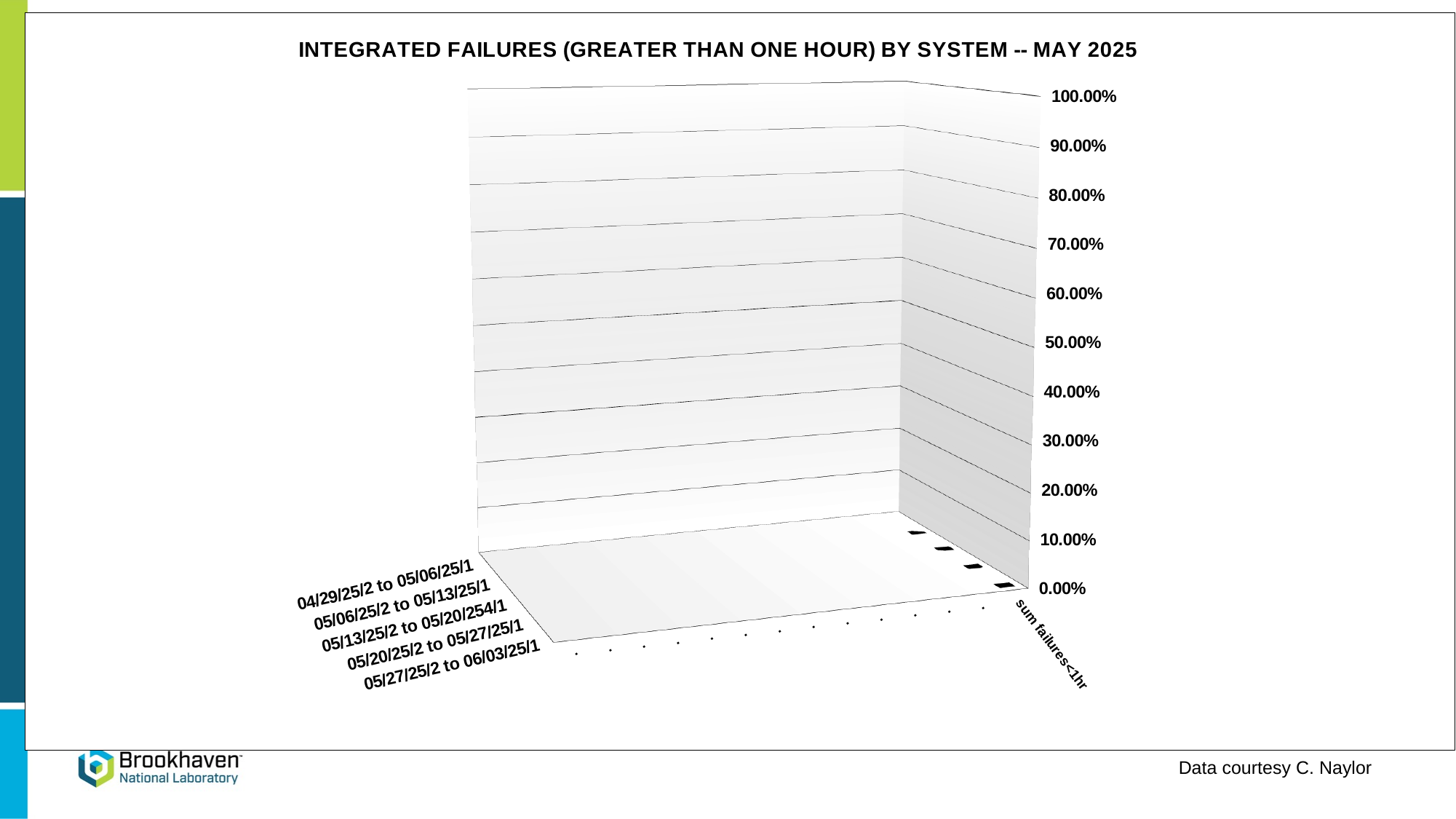
How many date-range categories are labelled along the left axis of the chart? 5 How many tick labels are shown on the vertical percentage axis? 11 Are any of the plotted values in the chart greater or less than 10.00%? less What is the highest tick label on the vertical axis of the chart? 100.00% What kind of chart is shown on the slide? bar chart What is the title of the chart? INTEGRATED FAILURES (GREATER THAN ONE HOUR) BY SYSTEM -- MAY 2025